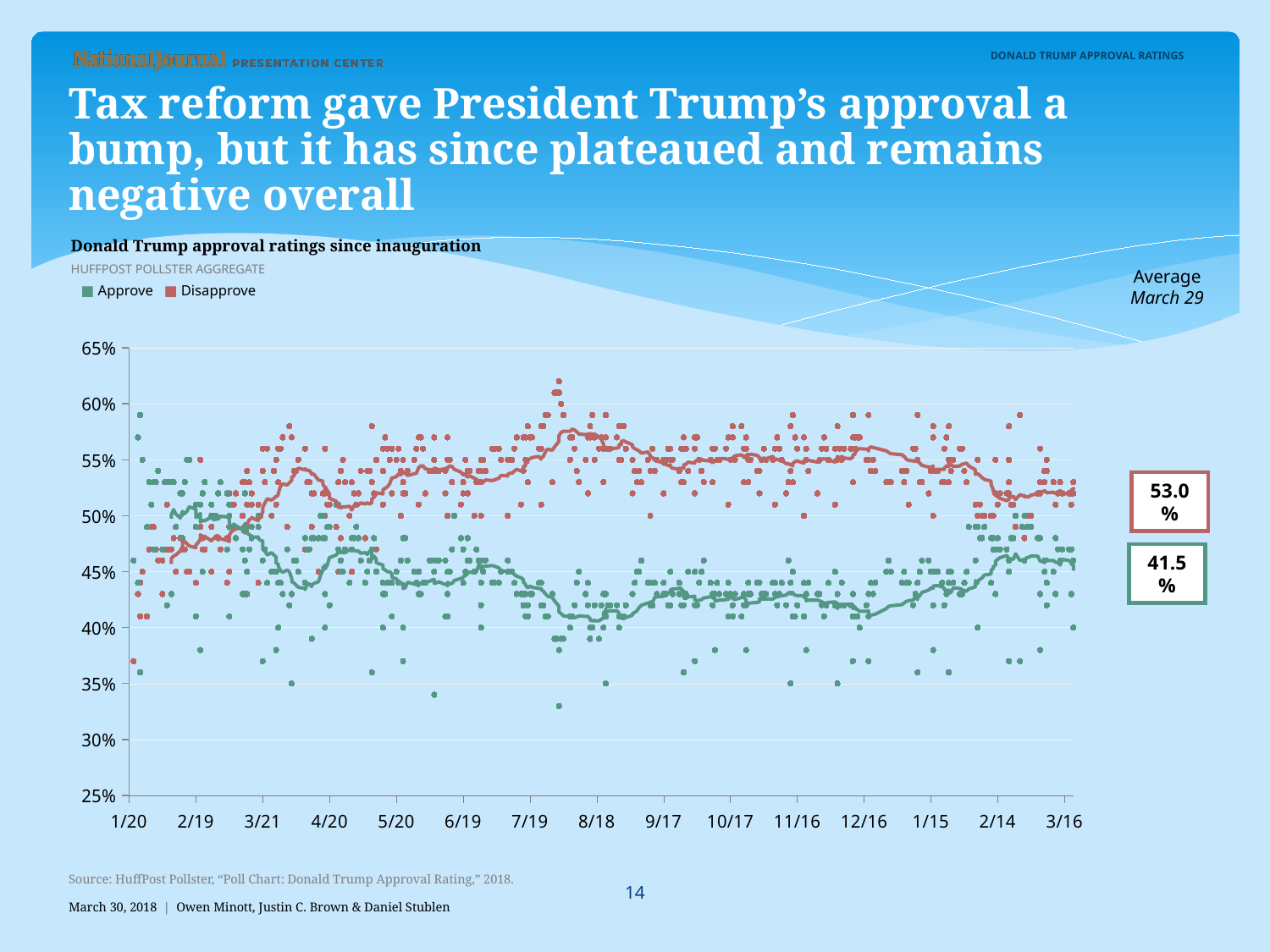
Is the Approve trend line at 1/20 greater or less than 45%? greater Does the Approve trend line rise or fall between 1/20 and 8/18? fall How many date labels are shown on the x axis? 15 What is the difference between the March 29 average Disapprove and Approve ratings? 11.5 percentage points What is the average Approve rating shown for March 29? 41.5% Is the Disapprove trend line at 1/20 greater or less than 50%? less On the March 29 averages, which is higher: Approve or Disapprove? Disapprove What is the average Disapprove rating shown for March 29? 53.0% What kind of chart is shown on the slide? line chart Is the Approve trend line at 8/18 greater or less than 45%? less How many series does the legend list? 2 Which colour represents Disapprove in the legend? red